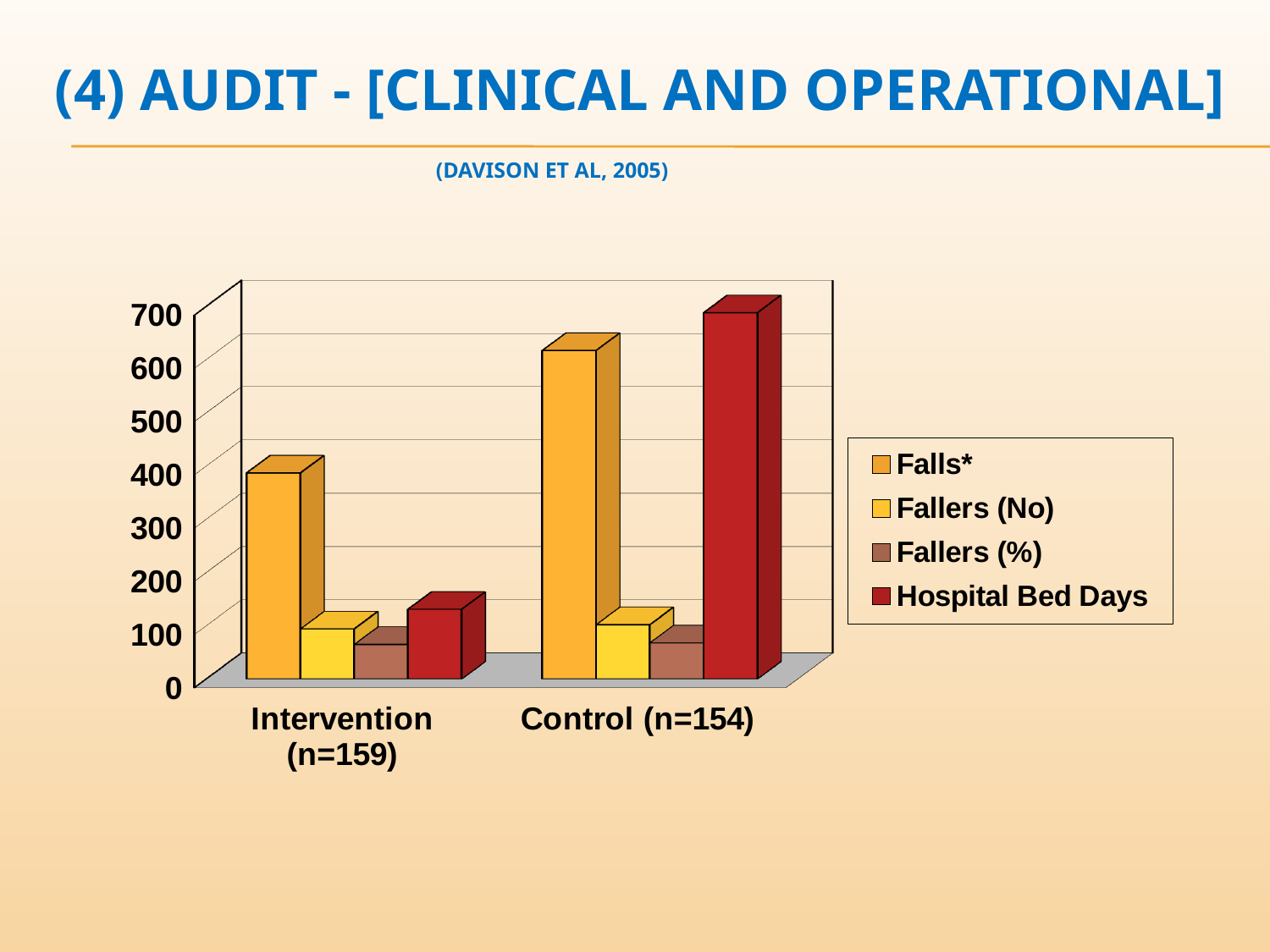
Is the value for Falls* in the Intervention (n=159) group greater or less than 500? less Is the value for Falls* in the Control (n=154) group greater or less than 500? greater Which series has the lowest value in the Intervention (n=159) group? Fallers (%) Is the value for Hospital Bed Days in the Control (n=154) group greater or less than 600? greater Which group has the higher value for Hospital Bed Days, Intervention (n=159) or Control (n=154)? Control (n=154) How many categories are shown on the x axis? 2 Which group has the higher value for Falls*, Intervention (n=159) or Control (n=154)? Control (n=154) How many series does the legend list? 4 Which series has the highest value in the Control (n=154) group? Hospital Bed Days What kind of chart is shown on the slide? bar chart